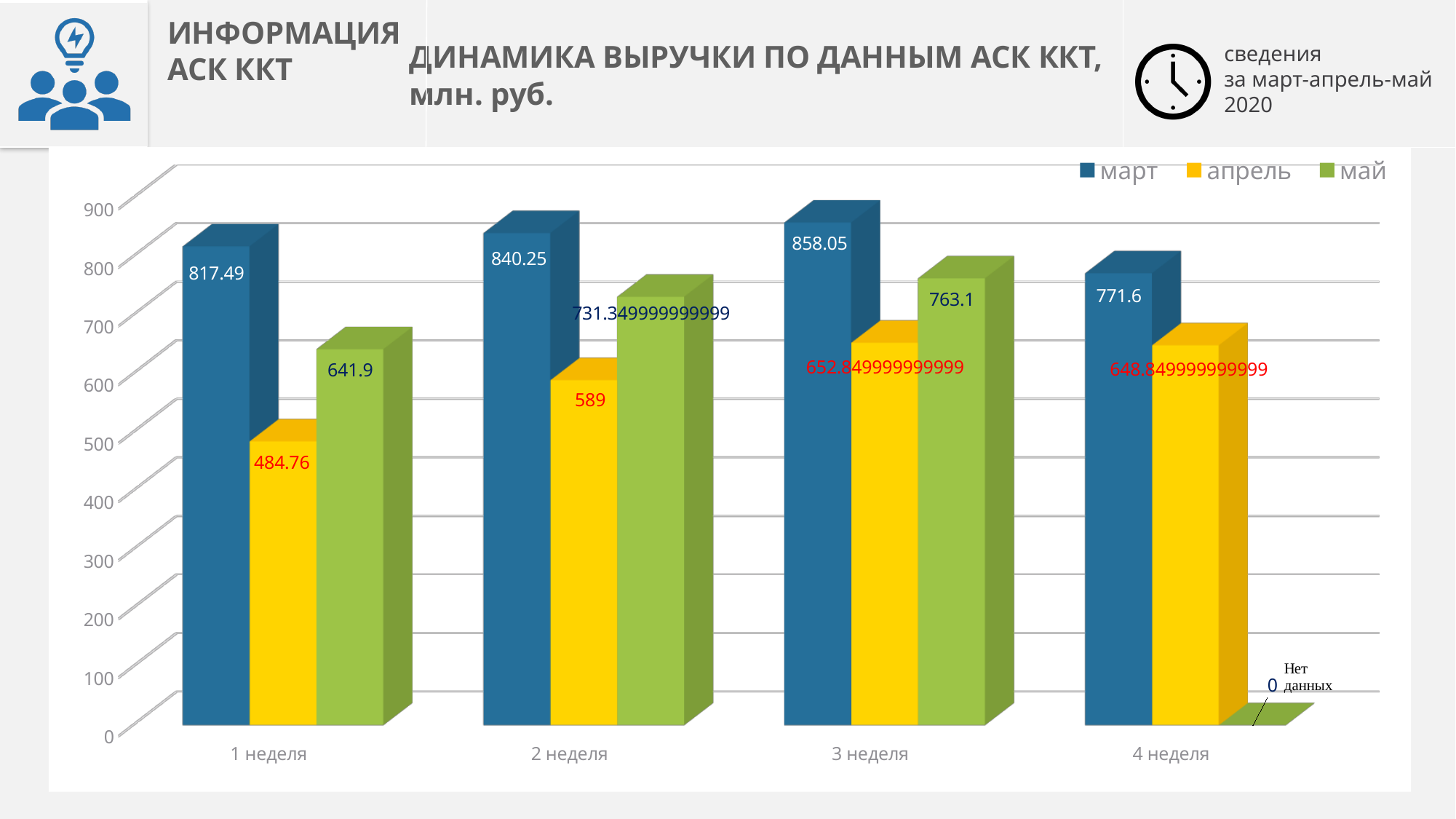
How many weeks are shown on the x axis? 4 In which week is the апрель value lowest? 1 неделя What is the value for май in 3 неделя? 763.1 How many series does the legend list? 3 What is the value for апрель in 2 неделя? 589 What is the value for май in 4 неделя? 0 What is the value for апрель in 3 неделя? 652.849999999999 In which week is the март value highest? 3 неделя What kind of chart is shown on the slide? bar chart What is the value for март in 1 неделя? 817.49 Which is larger in 2 неделя: март or май? март What is the difference between март and апрель in 1 неделя? 332.73